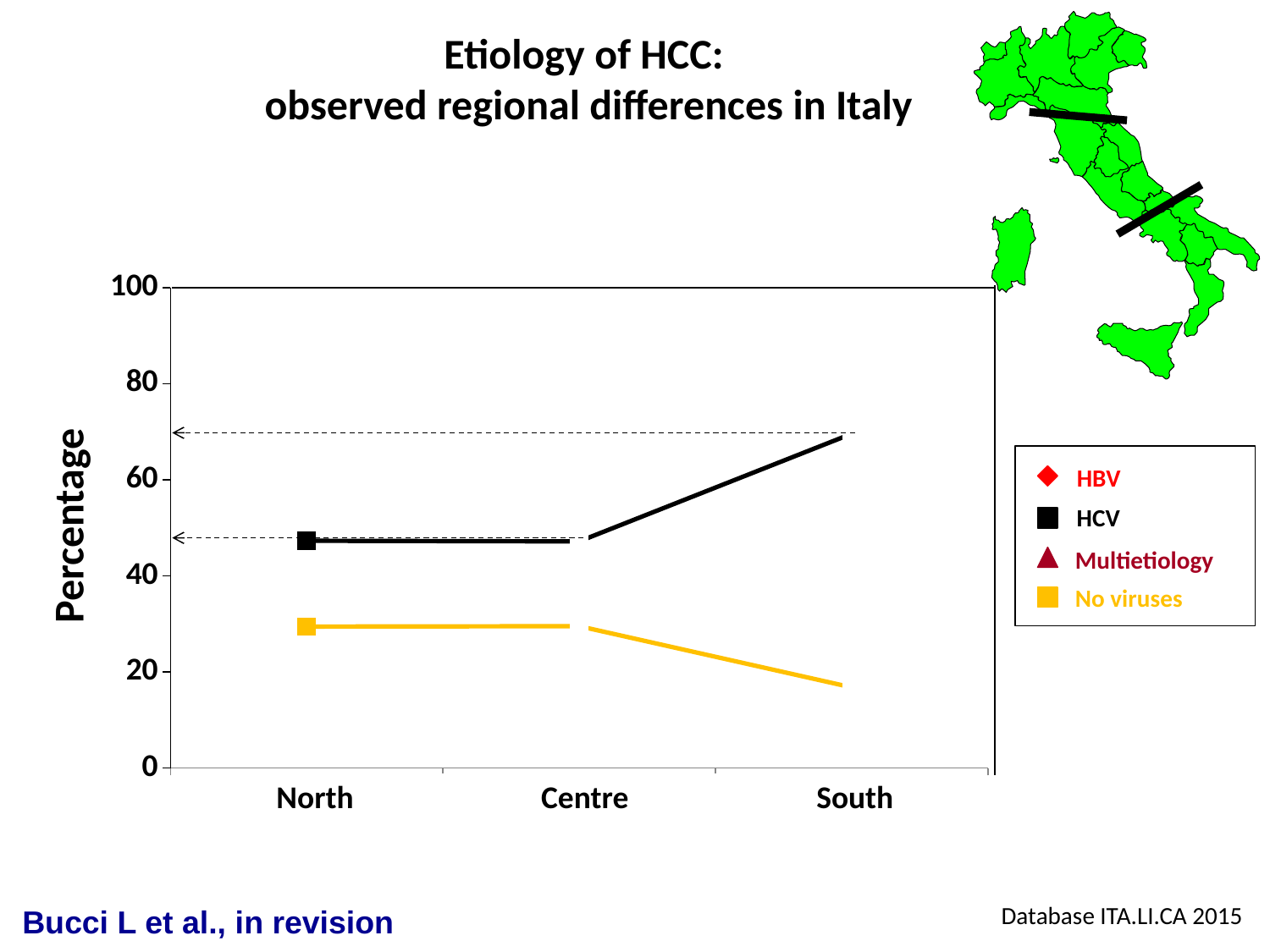
What is the label on the y axis? Percentage Is the value for HCV in the North greater or less than 40? greater Is the value for No viruses in the North greater or less than 40? less Is the value for HCV in the South greater or less than 60? greater In the South, which is larger, the HCV value or the No viruses value? HCV Does the No viruses line rise or fall from Centre to South? fall Which region has the highest HCV value? South How many series does the legend list? 4 What kind of chart is shown on the slide? line chart How many regions are shown on the x axis? 3 Which region has the lowest No viruses value? South